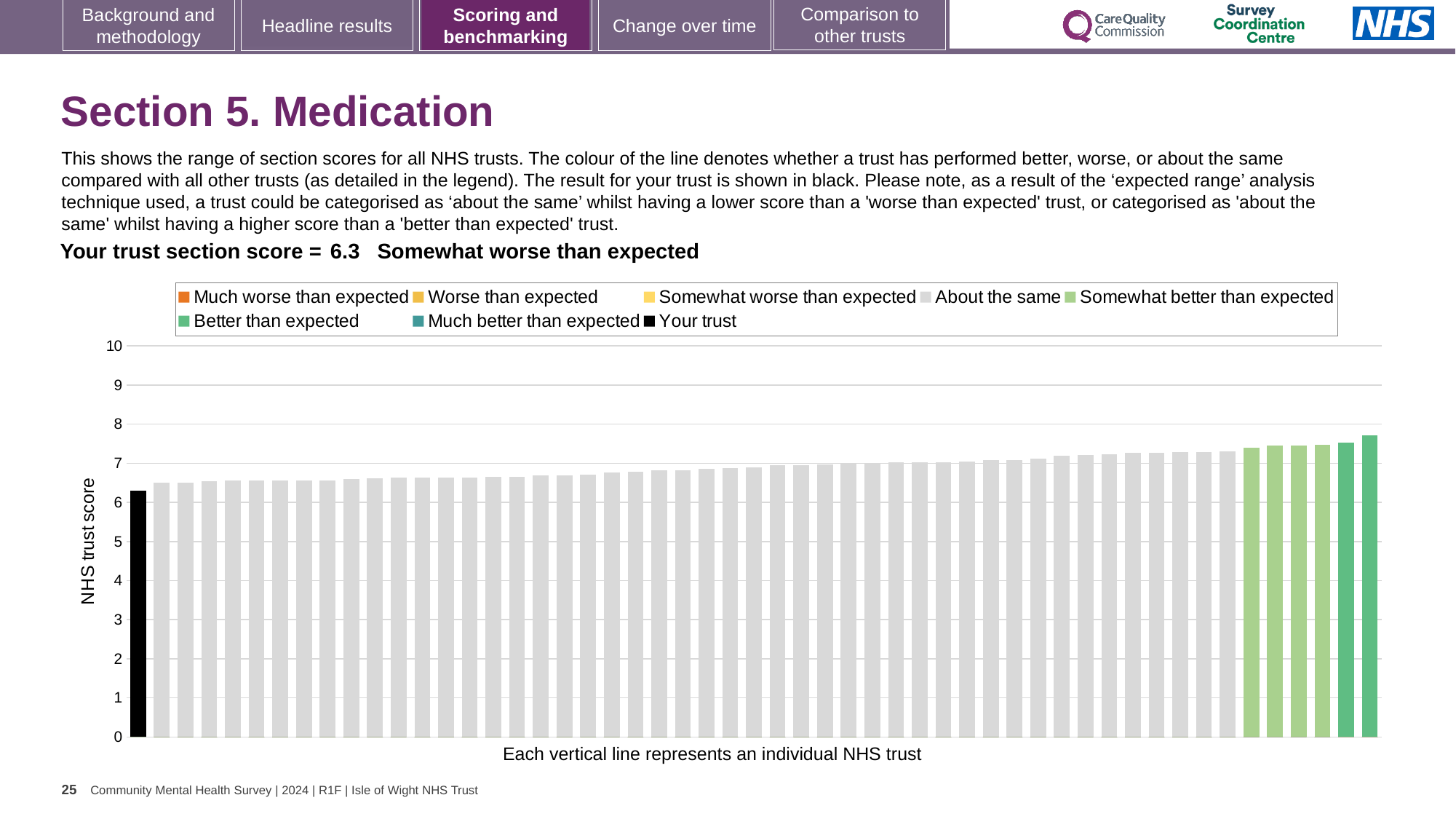
Which bar on the chart is the lowest? the black 'Your trust' bar (leftmost) What is the label on the vertical axis of the chart? NHS trust score How many entries does the chart legend list? 8 Do the bar values rise or fall from left to right along the x axis? rise Is the value of the tallest bar on the chart greater or less than 8? less What is the section score for your trust shown on the slide? 6.3 What kind of chart is shown on the slide? bar chart What colour is the bar representing your trust? black Is the value of the black 'Your trust' bar greater or less than 7? less Is the value of the tallest bar on the chart greater or less than 7? greater Which performance category is your trust assigned for Section 5. Medication? Somewhat worse than expected Is the 'Your trust' bar higher or lower than the rightmost bar on the chart? lower